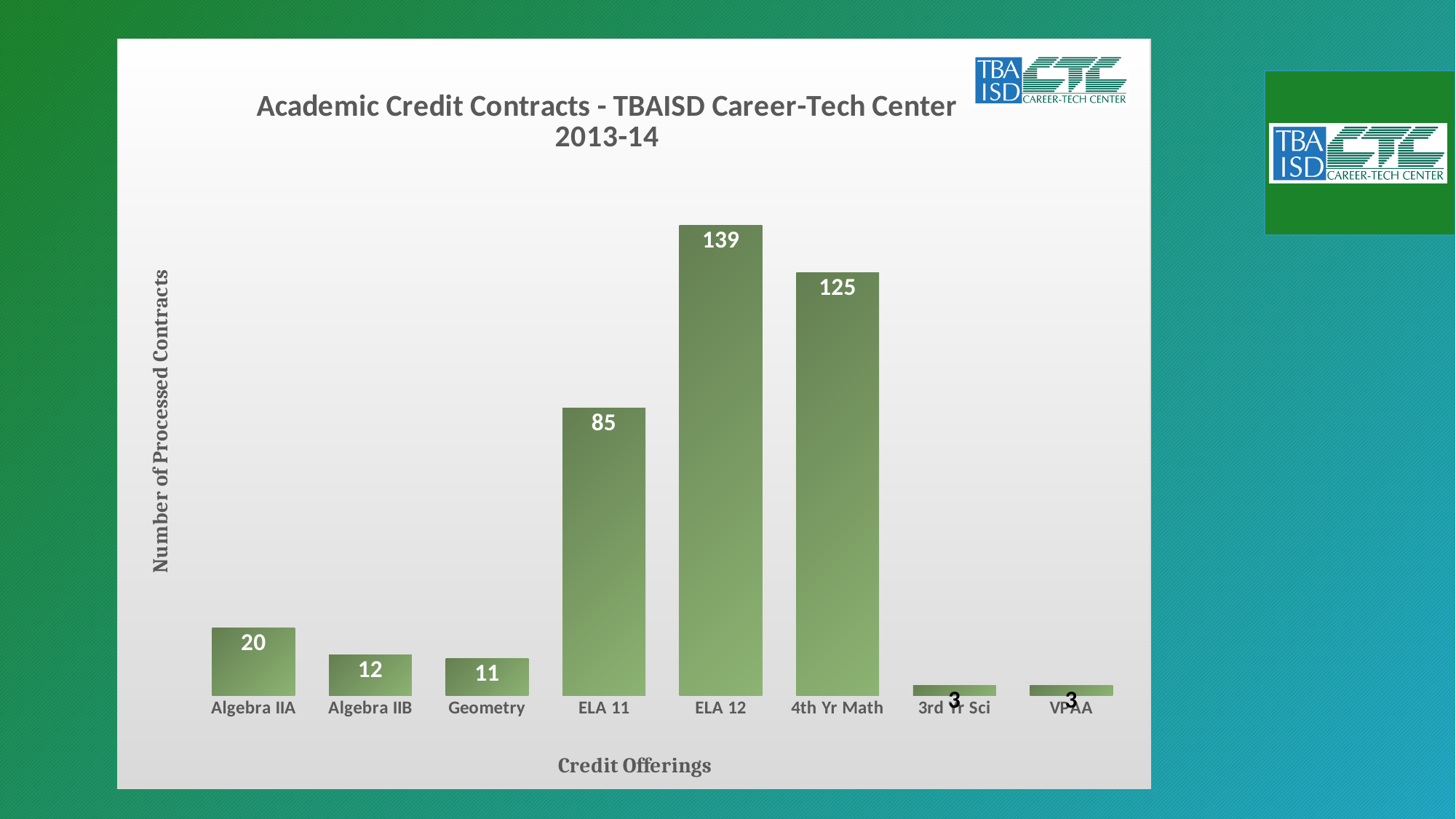
What is the number of processed contracts for Geometry? 11 Which has more processed contracts, 4th Yr Math or ELA 11? 4th Yr Math What is the difference in processed contracts between ELA 12 and 4th Yr Math? 14 What is the title of the chart? Academic Credit Contracts - TBAISD Career-Tech Center 2013-14 What is the label of the vertical axis? Number of Processed Contracts What is the number of processed contracts for ELA 12? 139 How many credit offerings are shown on the chart? 8 What is the difference in processed contracts between ELA 11 and Algebra IIB? 73 What is the number of processed contracts for Algebra IIA? 20 Which has more processed contracts, Algebra IIA or Algebra IIB? Algebra IIA What kind of chart is shown on the slide? Bar chart Which credit offering has the highest number of processed contracts? ELA 12